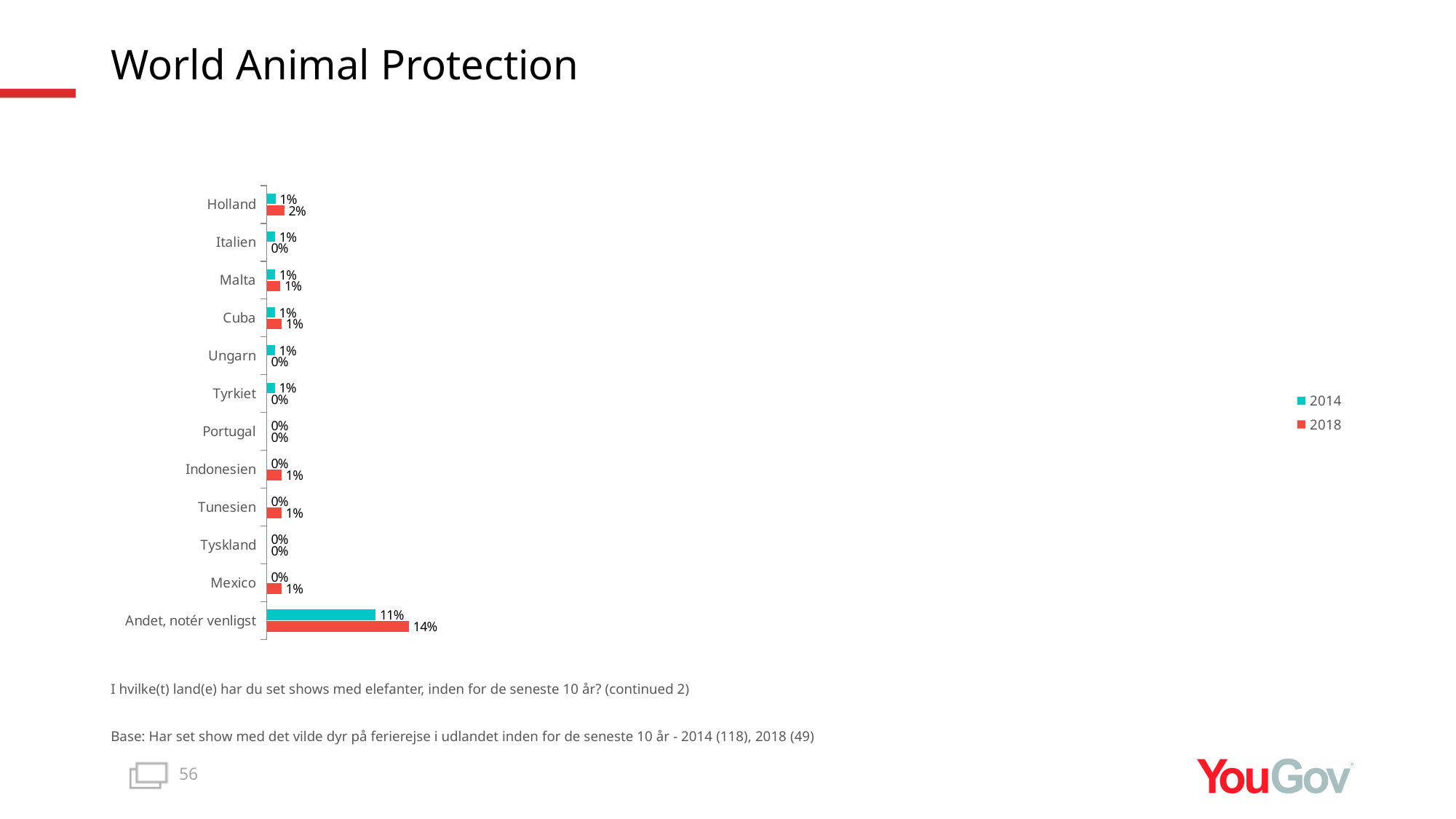
Which series is shown in red in the legend? 2018 Which is larger for Holland, the 2014 value or the 2018 value? 2018 What is the difference between the 2018 and 2014 values for Andet, notér venligst? 3% How many categories are shown on the chart? 12 What is the 2014 value for Italien? 1% Which category has the highest 2018 value? Andet, notér venligst What is the 2018 value for Mexico? 1% What kind of chart is shown on the slide? Bar chart How many series does the legend list? 2 What is the 2014 value for Andet, notér venligst? 11% What is the 2018 value for Tyskland? 0% What is the 2018 value for Holland? 2%